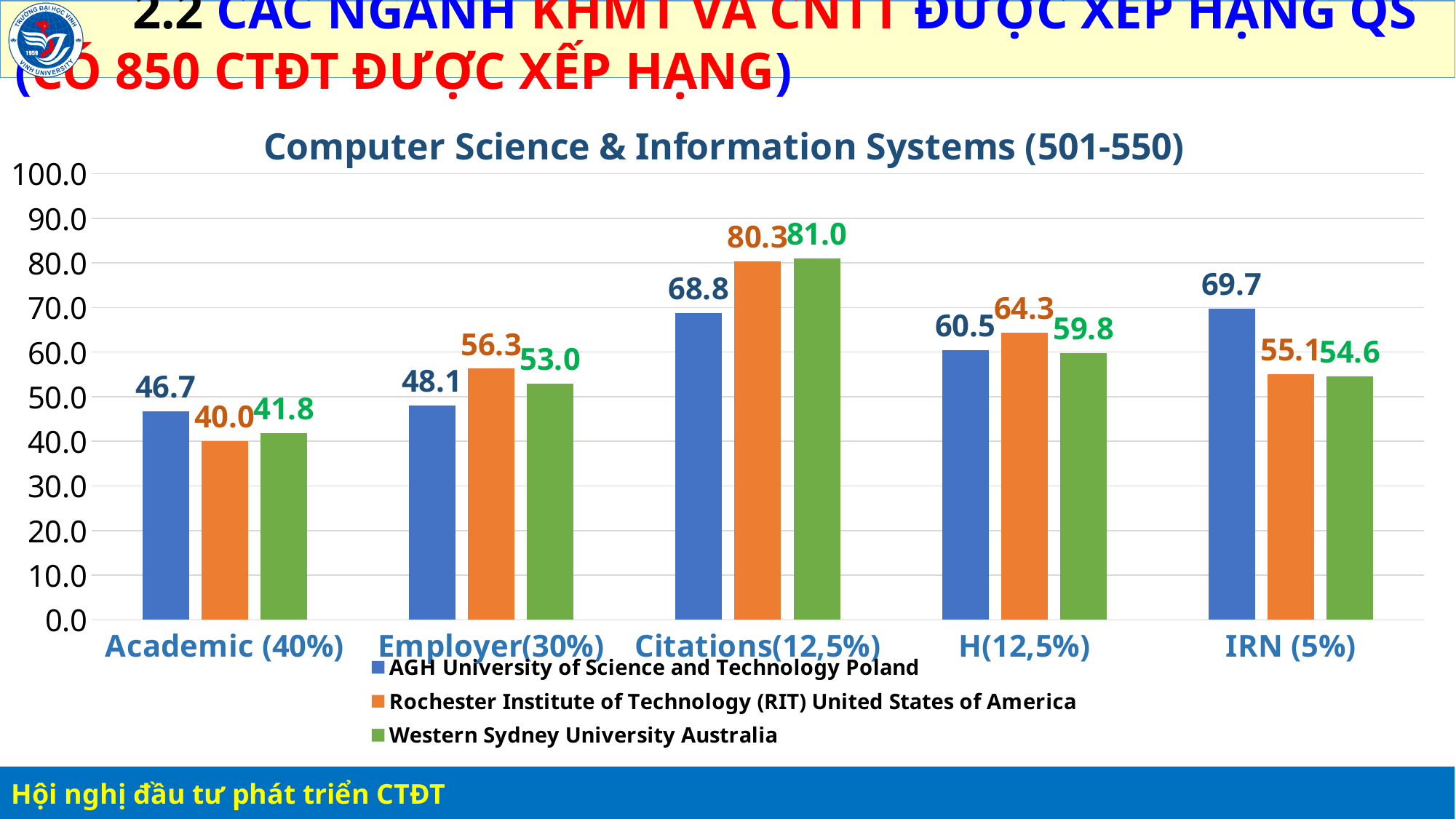
How many categories are shown on the x axis of the chart? 5 Is the value for Rochester Institute of Technology (RIT) in the Citations(12,5%) category greater or less than 70.0? greater What is the value for AGH University of Science and Technology Poland in the Academic (40%) category? 46.7 In which category does Rochester Institute of Technology (RIT) United States of America have its lowest value? Academic (40%) What is the title of the chart? Computer Science & Information Systems (501-550) In which category does AGH University of Science and Technology Poland have its highest value? IRN (5%) In the IRN (5%) category, which is larger: the value for AGH University of Science and Technology Poland or the value for Western Sydney University Australia? AGH University of Science and Technology Poland What is the value for Western Sydney University Australia in the Citations(12,5%) category? 81.0 How many series does the legend list? 3 What is the value for Rochester Institute of Technology (RIT) United States of America in the H(12,5%) category? 64.3 What is the difference between the Rochester Institute of Technology (RIT) value and the AGH University value in the Employer(30%) category? 8.2 What kind of chart is shown on the slide? bar chart